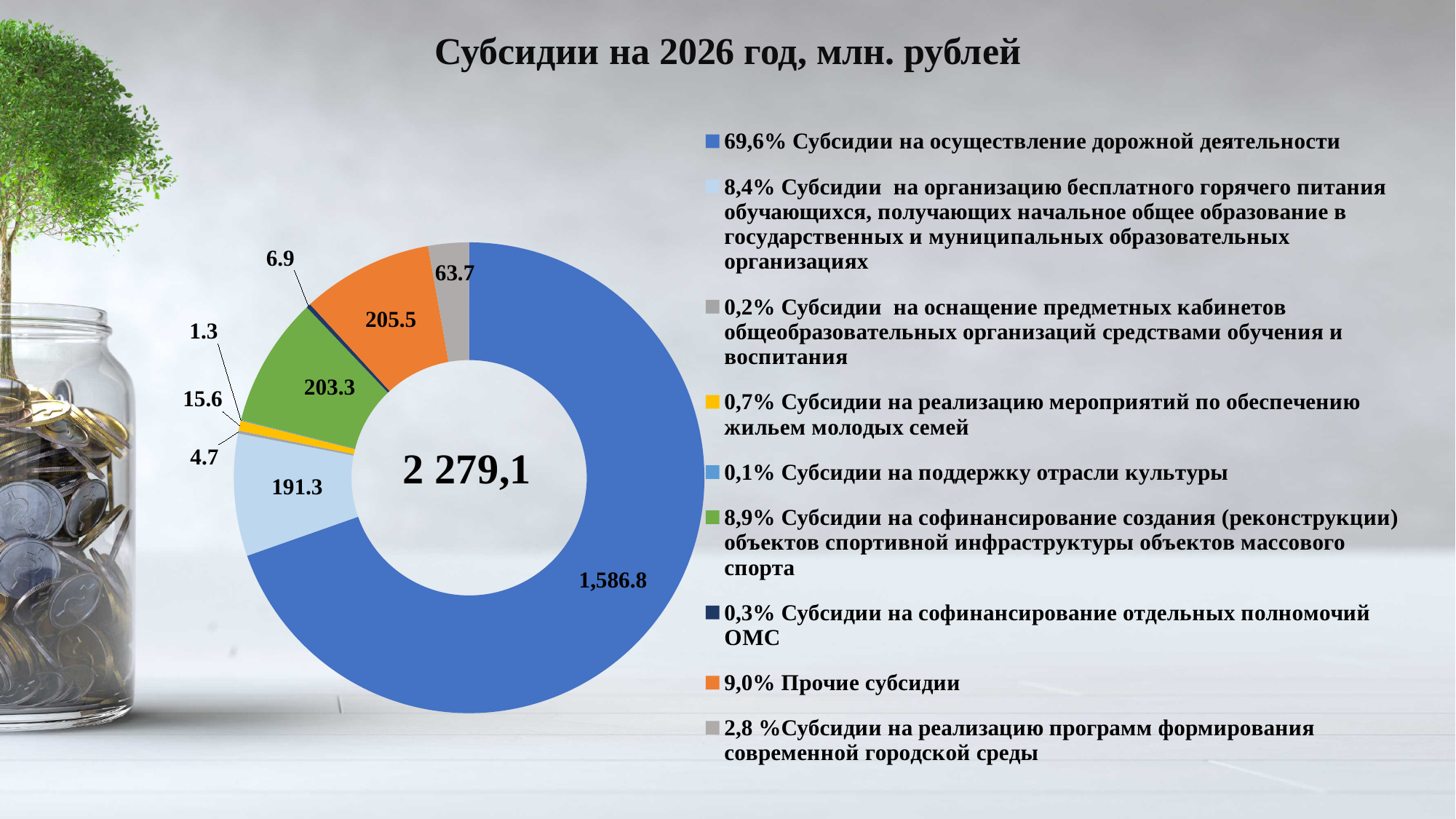
Which category has the largest value? Субсидии на осуществление дорожной деятельности What is the difference between Прочие субсидии and the sports infrastructure subsidies (203.3)? 2.2 Which is larger: the value for Субсидии на организацию бесплатного горячего питания (191.3) or the value for Прочие субсидии (205.5)? Прочие субсидии Which category has the smallest value? Субсидии на поддержку отрасли культуры What total is shown in the centre of the chart? 2 279,1 What is the title of the chart? Субсидии на 2026 год, млн. рублей What is the value for Субсидии на реализацию мероприятий по обеспечению жильем молодых семей? 15.6 What kind of chart is shown on the slide? doughnut (pie) chart What is the value for Субсидии на осуществление дорожной деятельности? 1,586.8 What is the value for Прочие субсидии? 205.5 What is the value for Субсидии на софинансирование создания (реконструкции) объектов спортивной инфраструктуры объектов массового спорта? 203.3 What share of the total do Субсидии на осуществление дорожной деятельности represent? 69,6%